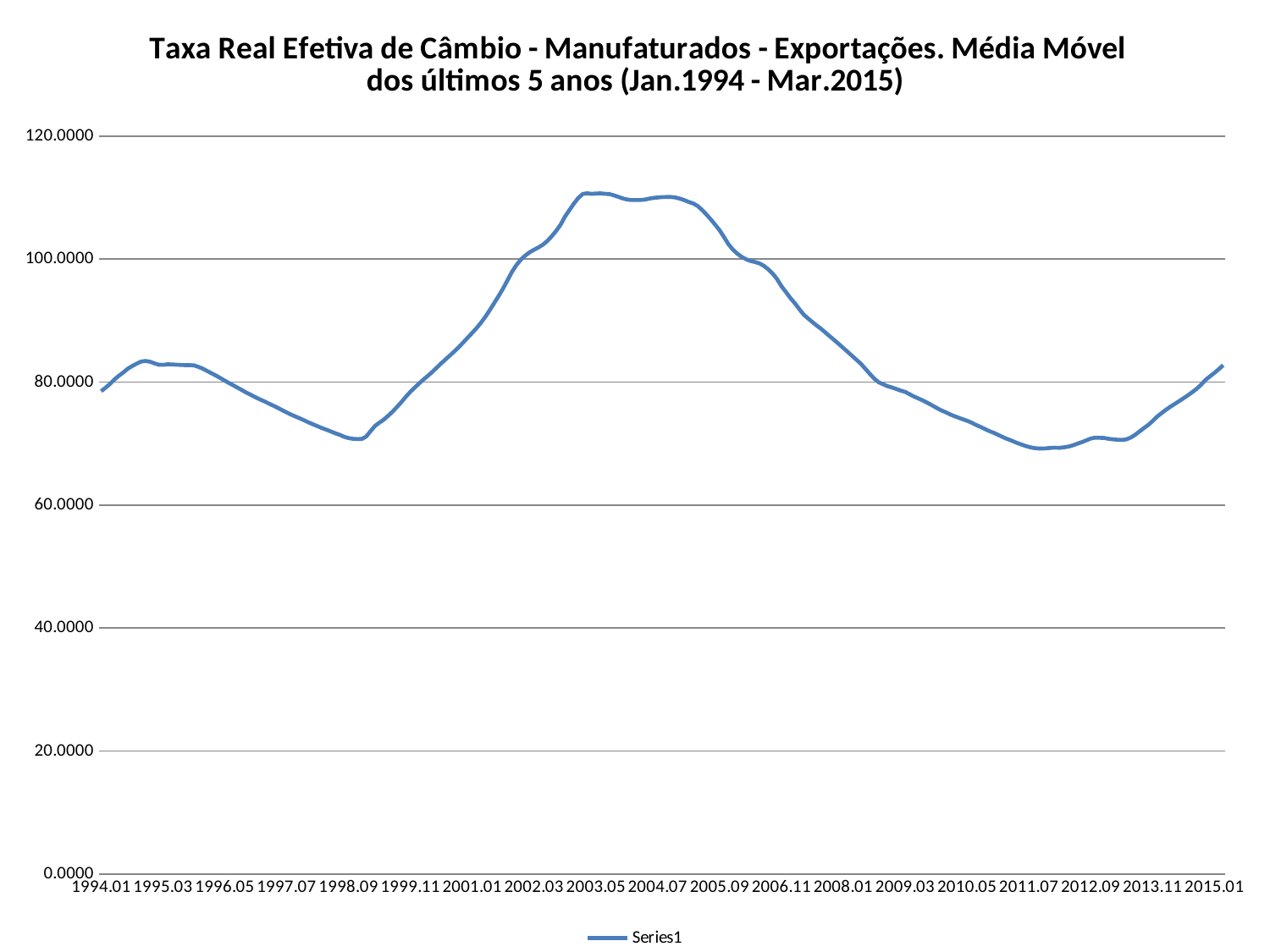
Is the value at 2011.07 greater or less than 80.0000? less Is the value at 1998.09 greater or less than 80.0000? less Is the value at 2003.05 greater or less than 100.0000? greater Does the line rise or fall between 2004.07 and 2011.07? fall How many series does the legend list? 1 What kind of chart is shown on the slide? line chart Which is larger, the value at 2003.05 or the value at 2011.07? 2003.05 What is the title of the chart? Taxa Real Efetiva de Câmbio - Manufaturados - Exportações. Média Móvel dos últimos 5 anos (Jan.1994 - Mar.2015) Does the line rise or fall between 1998.09 and 2003.05? rise What is the name of the series shown in the legend? Series1